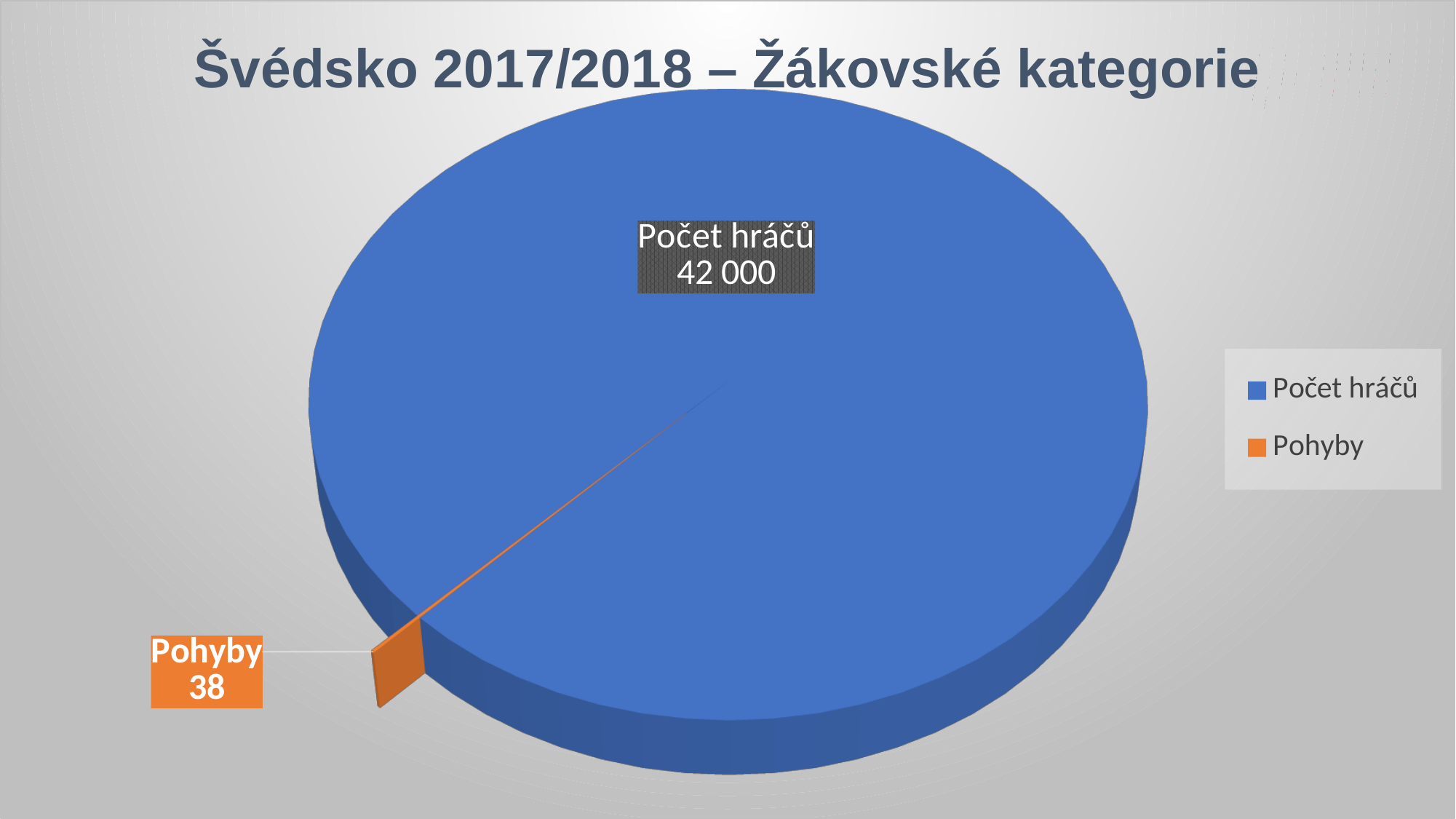
What colour is the Pohyby slice? Orange Which category has the smallest slice? Pohyby What is the total of the two values shown in the pie chart? 42 038 What is the value for Počet hráčů? 42 000 What is the difference between the values for Počet hráčů and Pohyby? 41 962 Which is larger, Počet hráčů or Pohyby? Počet hráčů Which category has the largest slice? Počet hráčů What is the title of the chart? Švédsko 2017/2018 – Žákovské kategorie How many slices does the pie chart have? 2 What kind of chart is shown on the slide? Pie chart How many entries does the legend list? 2 What is the value for Pohyby? 38